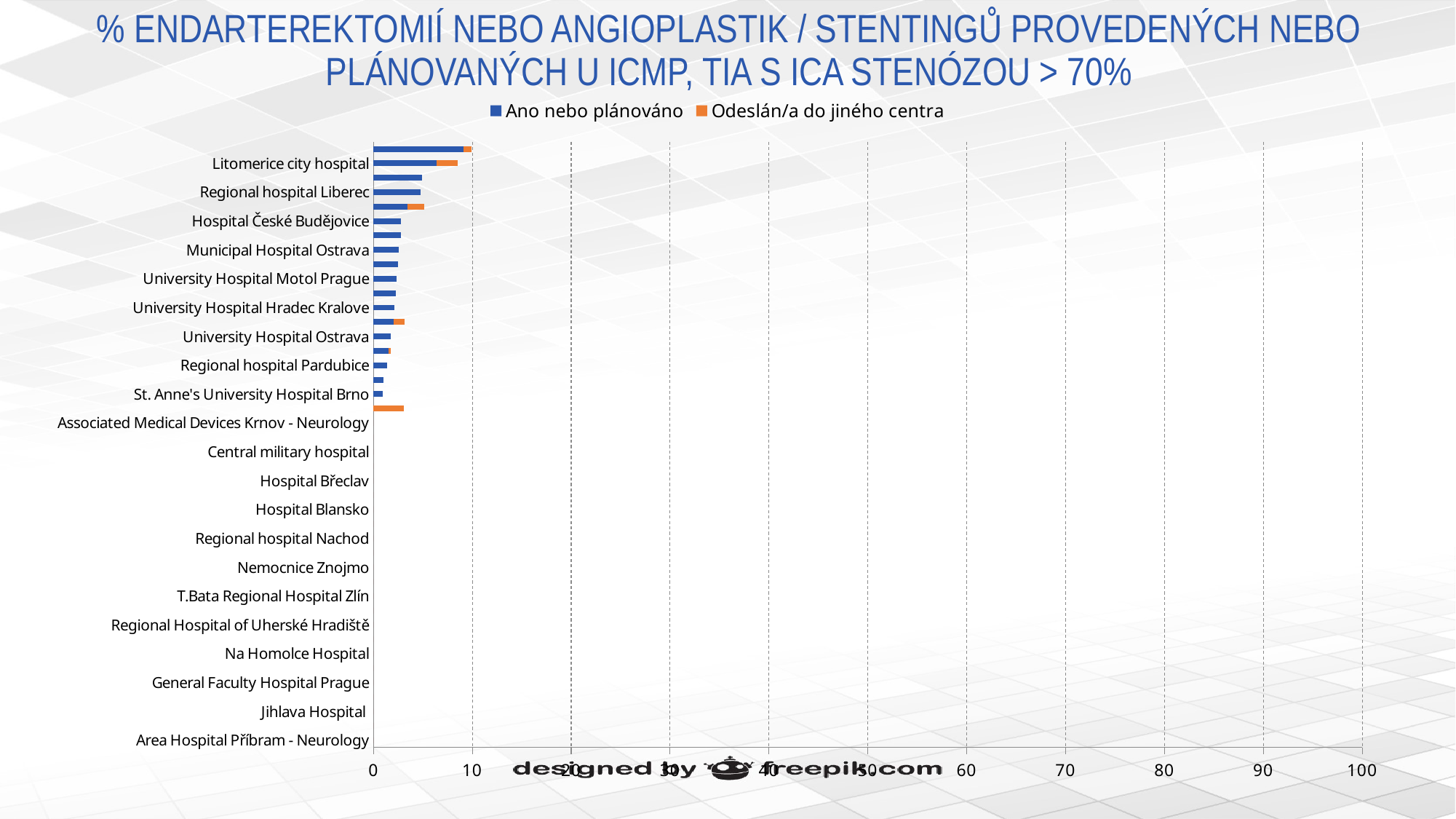
Is the total value for Litomerice city hospital greater or less than 10? less Which has the larger total value, Litomerice city hospital or Hospital České Budějovice? Litomerice city hospital Is the value for Area Hospital Příbram - Neurology greater or less than 10? less What is the highest value shown on the horizontal axis? 100 What kind of chart is shown on the slide? bar chart Is the value for Regional hospital Liberec greater or less than 10? less What are the two series named in the legend? Ano nebo plánováno; Odeslán/a do jiného centra Which has the larger total value, Litomerice city hospital or Regional hospital Liberec? Litomerice city hospital How many series does the legend list? 2